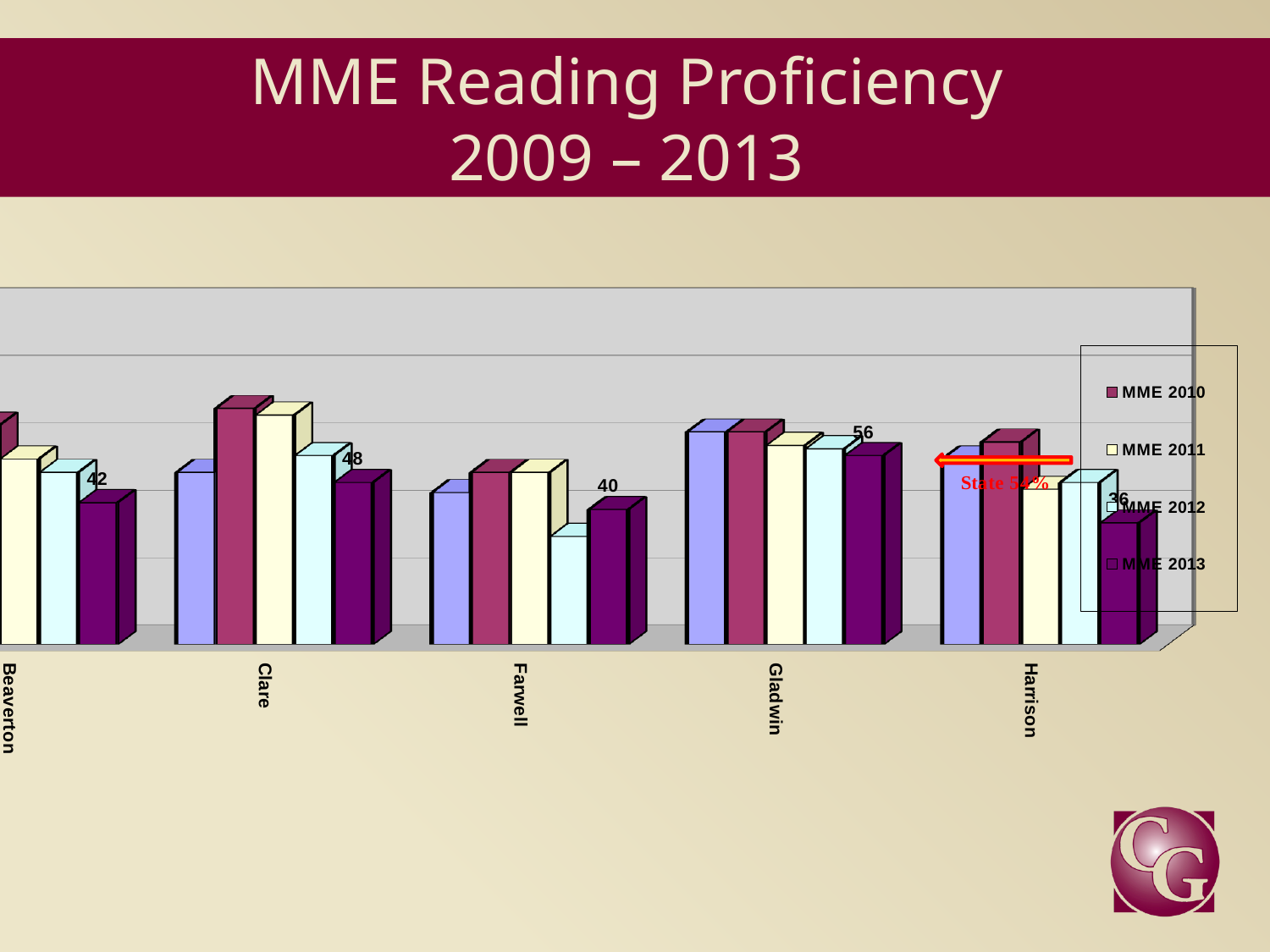
What is the MME 2013 reading proficiency value labeled for Farwell? 40 What is the difference between the labeled MME 2013 values for Gladwin and Harrison? 20 What is the MME 2013 reading proficiency value labeled for Harrison? 36 Which district has the highest labeled MME 2013 value? Gladwin What is the difference between the labeled MME 2013 values for Clare and Farwell? 8 What is the MME 2013 reading proficiency value labeled for Beaverton? 42 How many school districts are shown along the x axis of the chart? 5 Which has the larger labeled MME 2013 value, Clare or Beaverton? Clare What is the MME 2013 reading proficiency value labeled for Gladwin? 56 What state proficiency percentage is annotated on the chart? State 54% What kind of chart is shown on the slide? bar chart Which district has the lowest labeled MME 2013 value? Harrison